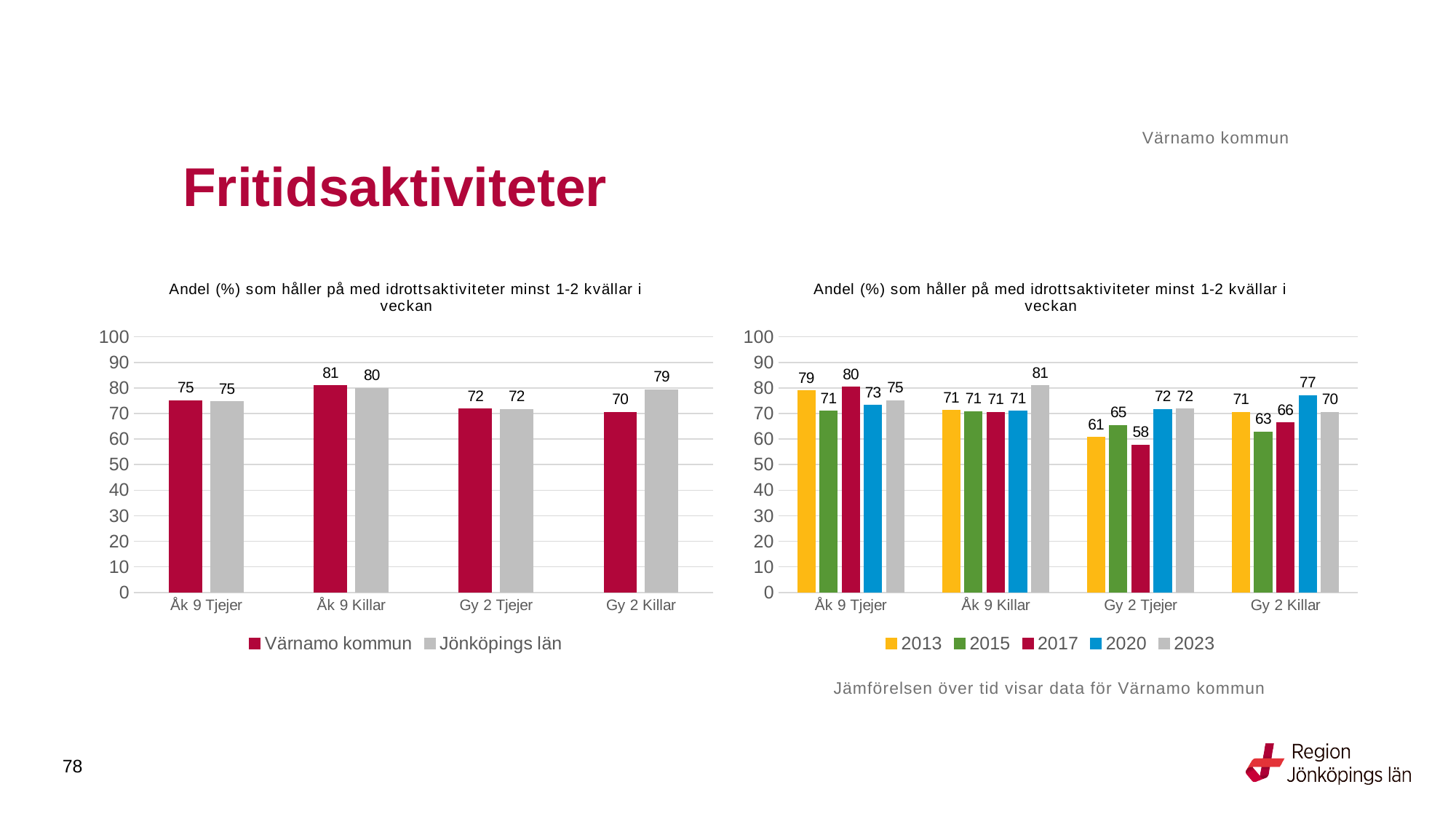
In the left chart, how many series does the legend list? 2 In the right chart, which year has the lowest value for Åk 9 Tjejer? 2015 In the right chart, what is the difference between the 2023 and 2013 values for Gy 2 Tjejer? 11 In the right chart, how many series does the legend list? 5 What kind of chart is the left chart? Bar chart In the left chart, what is the difference between Jönköpings län and Värnamo kommun for Gy 2 Killar? 9 In the left chart, what is the value for Jönköpings län for Gy 2 Killar? 79 In the right chart, what is the value for 2017 for Gy 2 Tjejer? 58 In the left chart, what is the value for Värnamo kommun for Åk 9 Killar? 81 In the right chart, what is the value for 2023 for Åk 9 Killar? 81 In the left chart, which category has the lowest value for Värnamo kommun? Gy 2 Killar In the right chart, which year has the highest value for Gy 2 Killar? 2020